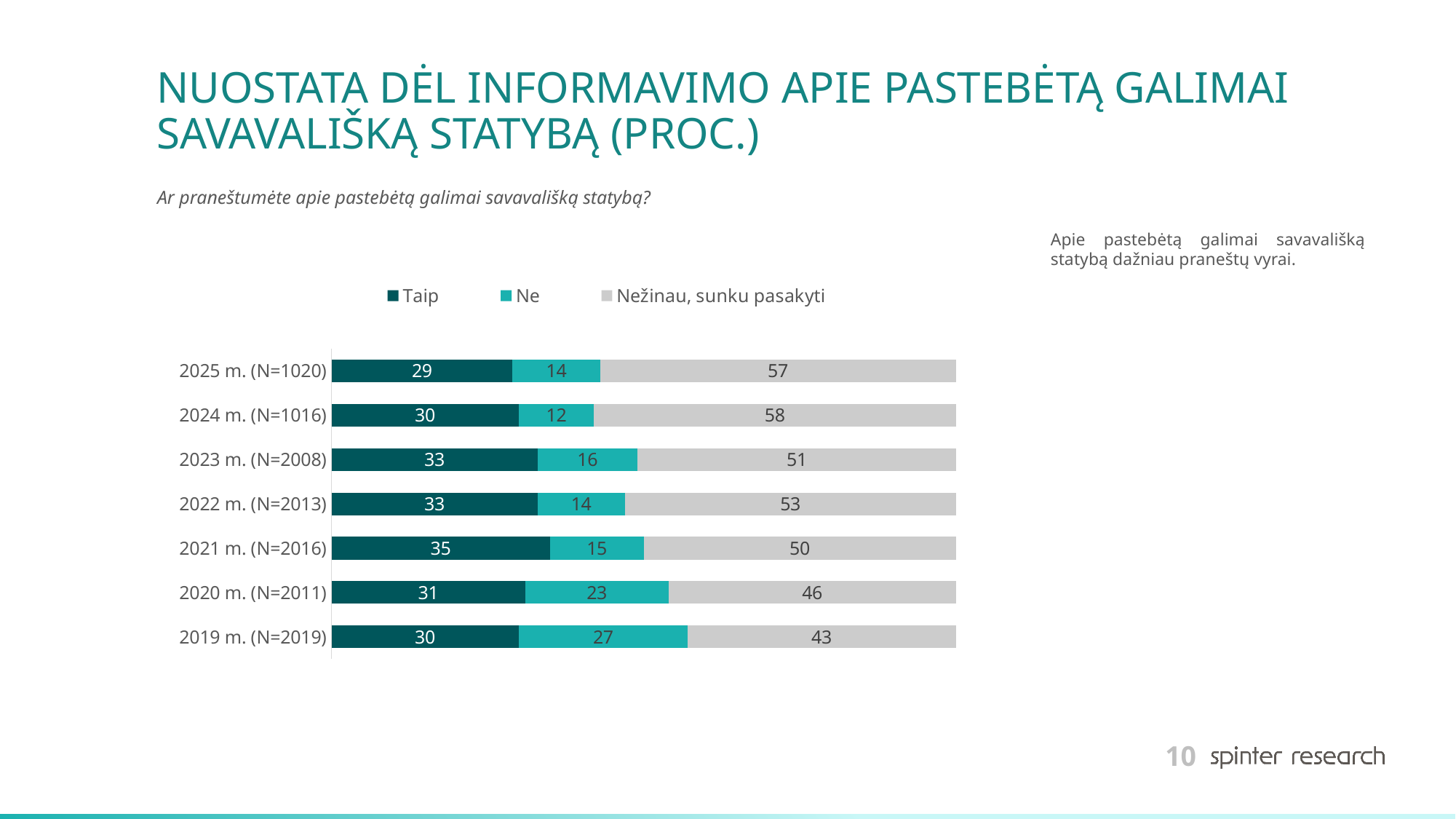
Which year has the highest value for "Taip"? 2021 m. (N=2016) What is the difference between the "Ne" value in 2019 m. (N=2019) and in 2025 m. (N=1020)? 13 How many series does the legend list? 3 What kind of chart is shown on the slide? Stacked bar chart Which year has the larger "Taip" value, 2023 m. (N=2008) or 2020 m. (N=2011)? 2023 m. (N=2008) How many years (categories) are shown in the chart? 7 Which year has the highest value for "Nežinau, sunku pasakyti"? 2024 m. (N=1016) What is the value for "Nežinau, sunku pasakyti" in 2021 m. (N=2016)? 50 Which year has the lowest value for "Ne"? 2024 m. (N=1016) What is the total of the stacked bar for 2025 m. (N=1020)? 100 What is the value for "Taip" in 2025 m. (N=1020)? 29 What is the value for "Ne" in 2019 m. (N=2019)? 27